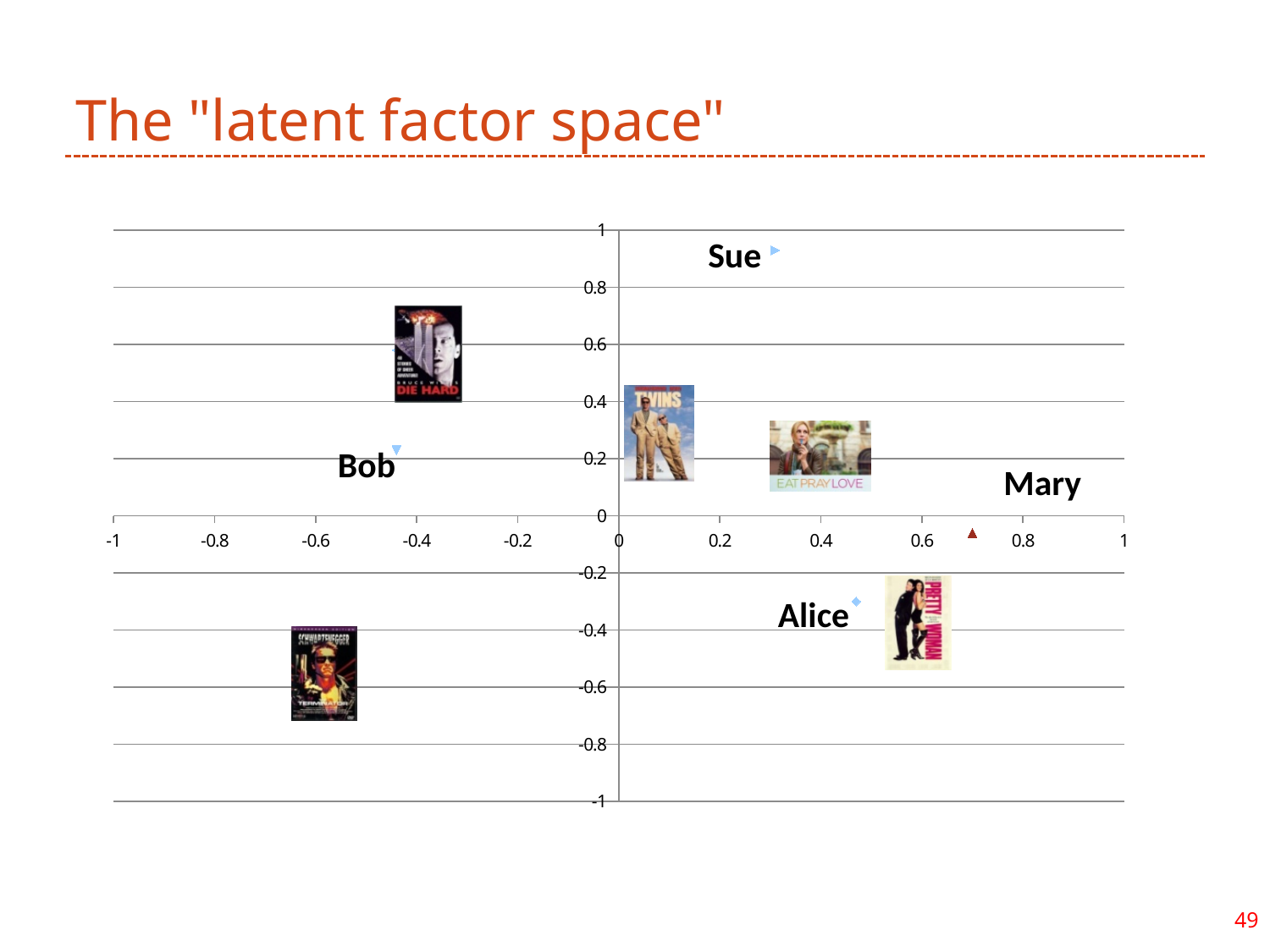
Which named user point has the highest vertical-axis value? Sue Is the horizontal-axis value for Mary greater or less than 0.6? greater Which named user point is furthest to the left on the horizontal axis? Bob Is the horizontal-axis value for Bob greater or less than -0.2? less How many named user points (Sue, Bob, Mary, Alice) are plotted on the chart? 4 Which named user point is furthest to the right on the horizontal axis? Mary Is the vertical-axis value for Alice greater or less than -0.2? less Which named user point has the lowest vertical-axis value? Alice What kind of chart is shown on the slide? scatter chart Which has the larger horizontal-axis value, Mary or Alice? Mary What is the title of the slide containing the chart? The "latent factor space"